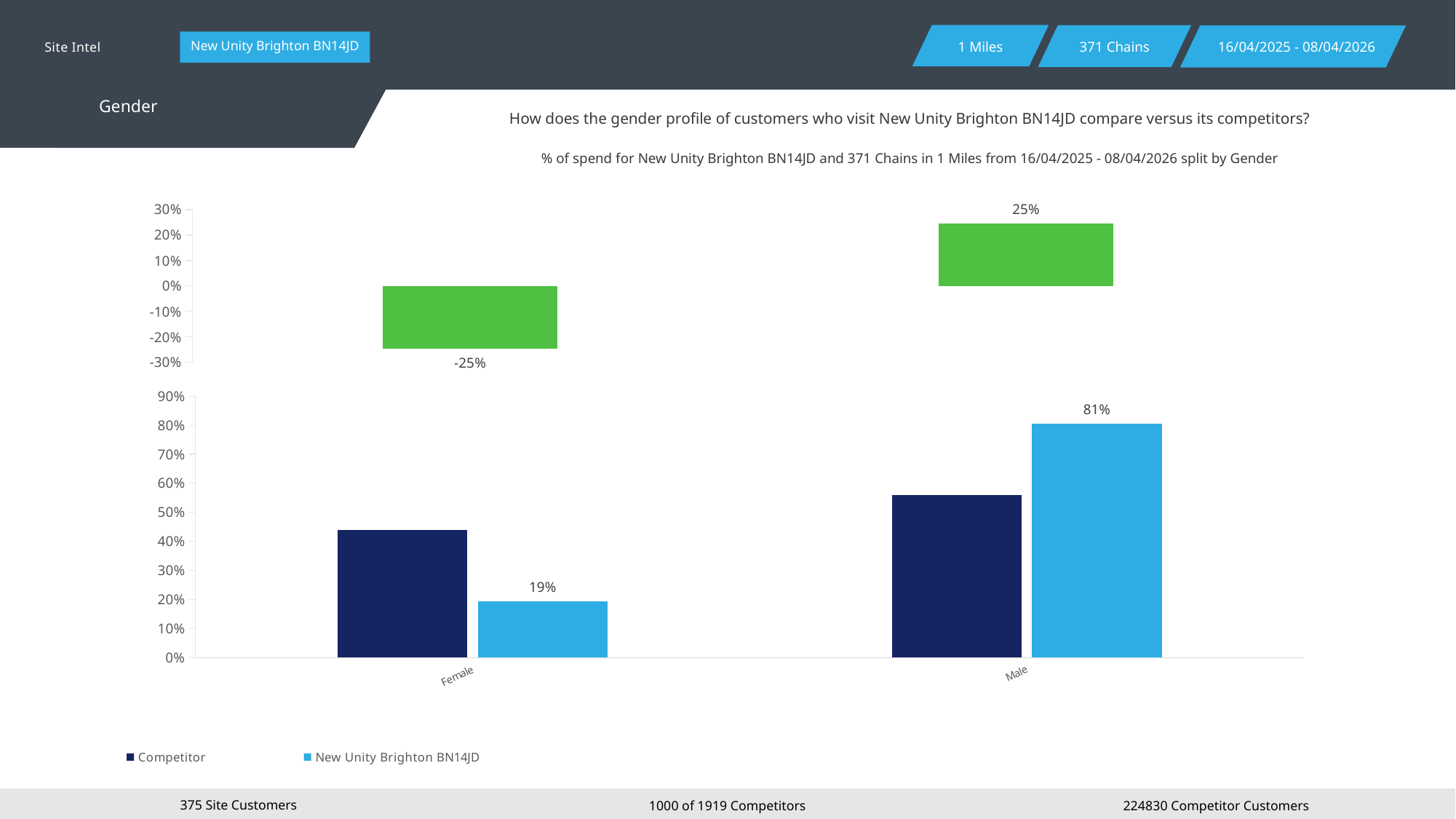
In the bottom chart, is the Competitor value for Male greater or less than 60%? less In the bottom chart, what is the value for New Unity Brighton BN14JD for Female? 19% In the bottom chart, what is the value for New Unity Brighton BN14JD for Male? 81% In the top chart, what is the value shown for Male? 25% How many categories are shown on the x axis of the bottom chart? 2 In the top chart, what is the value shown for Female? -25% In the bottom chart, what is the difference between the New Unity Brighton BN14JD values for Male and Female? 62% In the bottom chart, is the Competitor value for Female greater or less than 40%? greater How many series does the legend of the bottom chart list? 2 In the bottom chart, which category has the higher value for New Unity Brighton BN14JD, Female or Male? Male In the bottom chart, for Male, which series has the larger value, Competitor or New Unity Brighton BN14JD? New Unity Brighton BN14JD What type of chart is the bottom chart? Bar chart